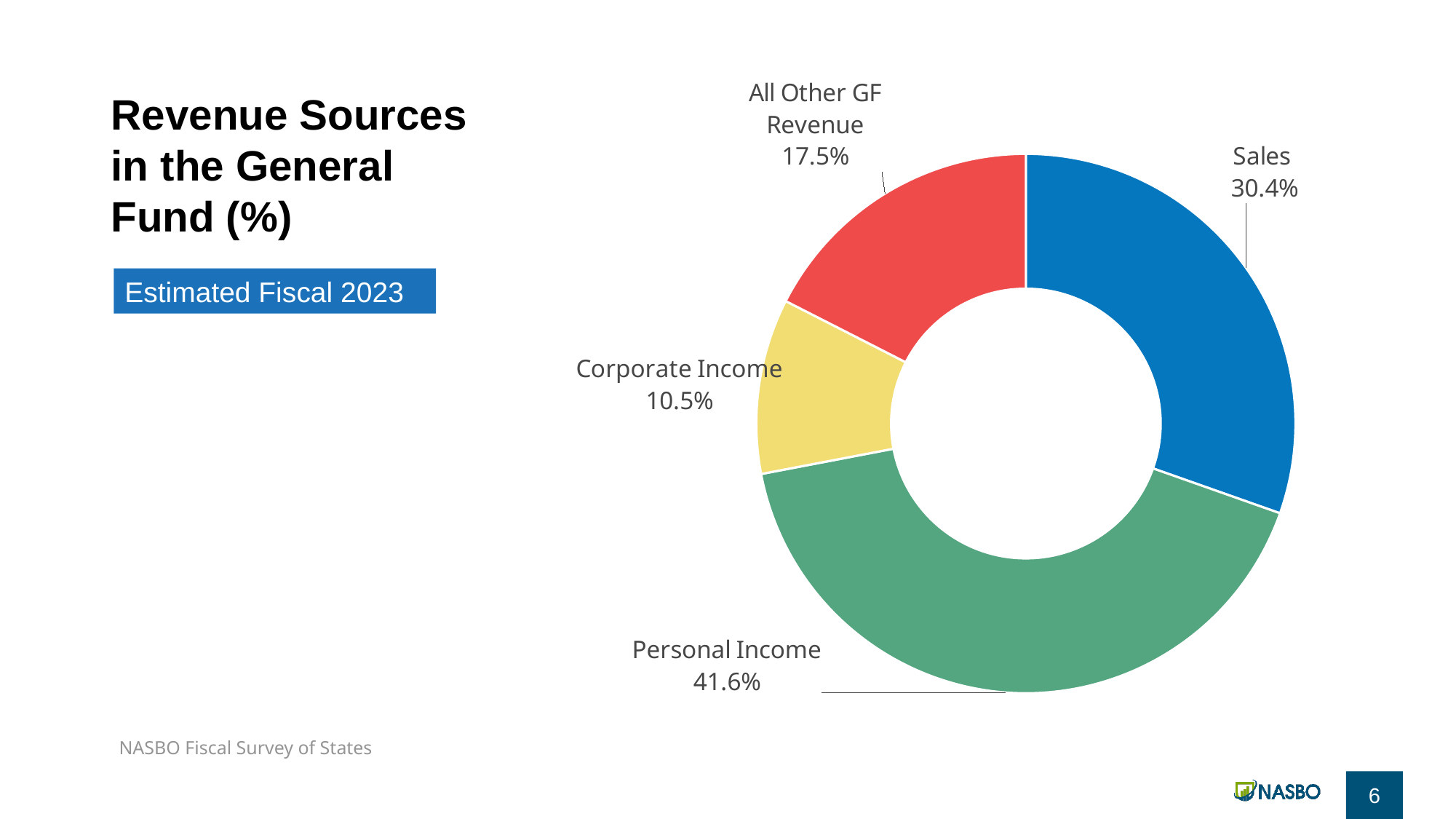
What share of General Fund revenue comes from Corporate Income? 10.5% What share of General Fund revenue comes from Sales? 30.4% What kind of chart is shown on the slide? Doughnut (pie) chart What share of General Fund revenue comes from Personal Income? 41.6% Which revenue source has the smallest share of the General Fund? Corporate Income How many revenue sources are shown in the chart? 4 What is the difference in percentage points between Personal Income and Sales? 11.2 What is the difference in percentage points between All Other GF Revenue and Corporate Income? 7.0 What share of General Fund revenue comes from All Other GF Revenue? 17.5% Which is larger, the share for Sales or the share for All Other GF Revenue? Sales Which revenue source has the largest share of the General Fund? Personal Income Which fiscal year does the chart cover? Estimated Fiscal 2023